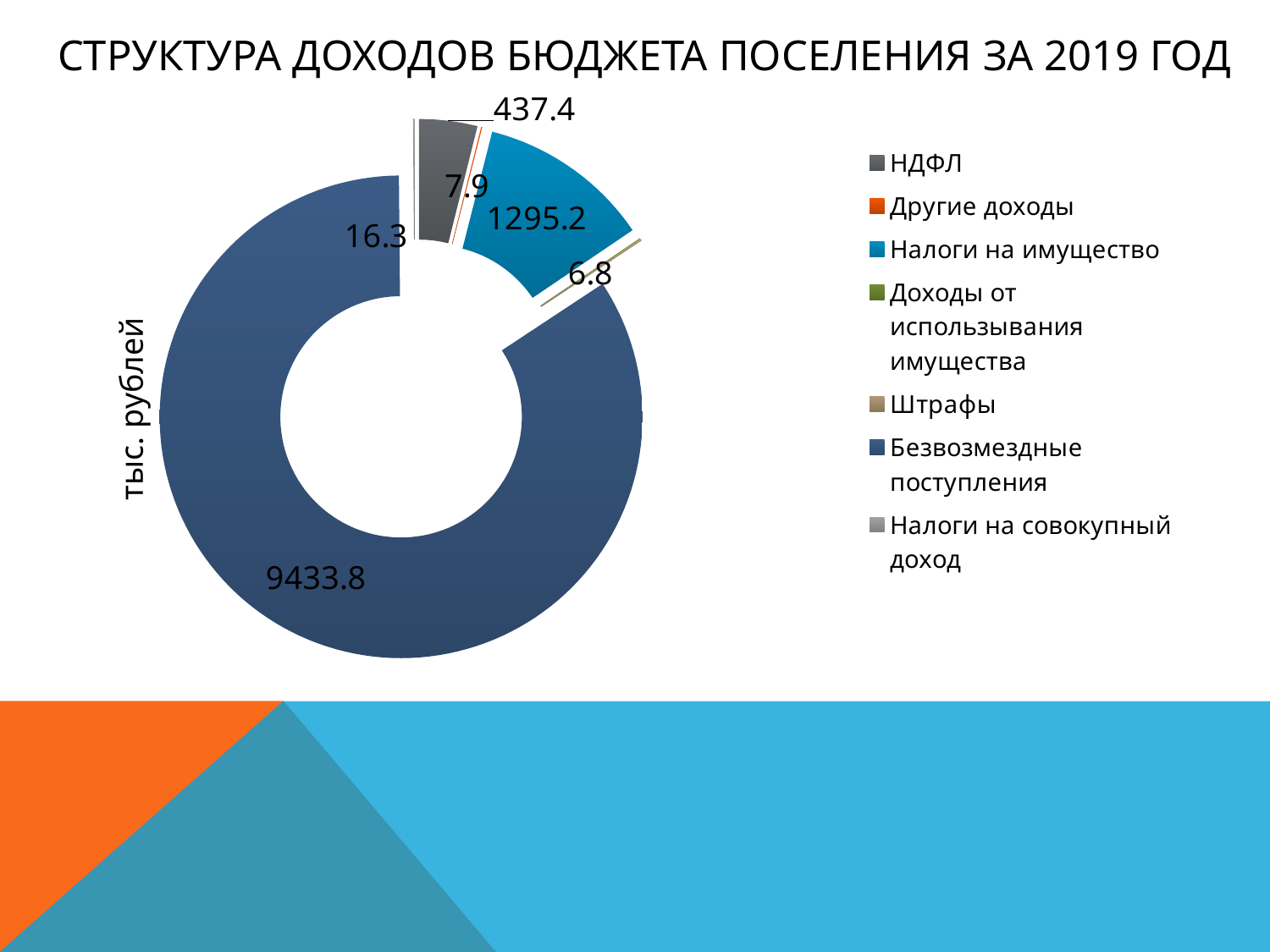
What is the value for Другие доходы? 7.9 What unit is shown on the label to the left of the chart? тыс. рублей What kind of chart is shown on the slide? doughnut chart What is the value for Безвозмездные поступления? 9433.8 What is the value for Налоги на имущество? 1295.2 Which category has the largest share of the doughnut? Безвозмездные поступления What is the difference between Безвозмездные поступления and Налоги на имущество? 8138.6 What is the value for Налоги на совокупный доход? 16.3 How many categories does the legend list? 7 What is the value for НДФЛ? 437.4 Which is larger, НДФЛ or Налоги на имущество? Налоги на имущество What is the difference between Налоги на имущество and НДФЛ? 857.8